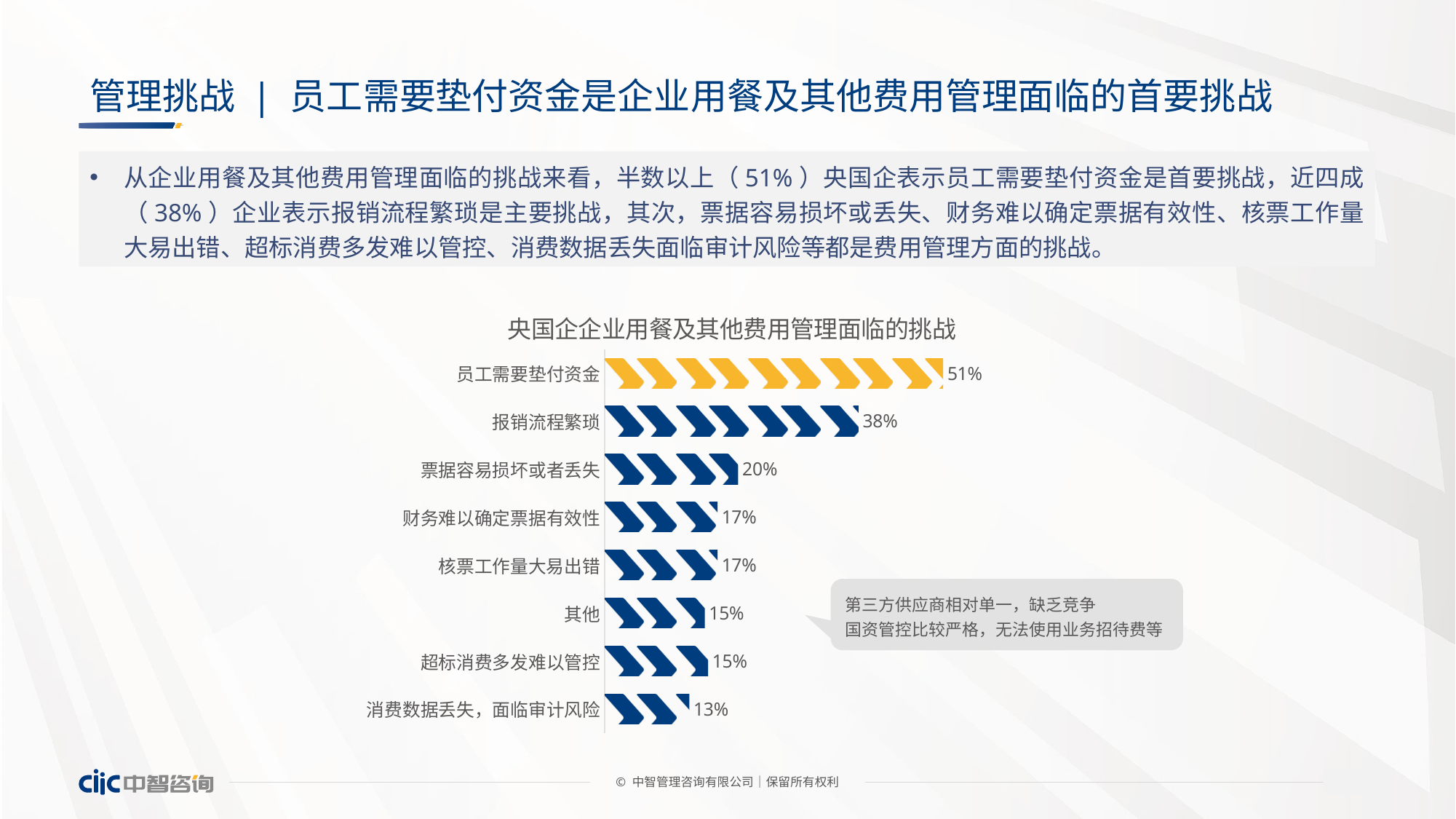
What is the value for 消费数据丢失，面临审计风险? 13% What is the value for 报销流程繁琐? 38% What is the title of the chart? 央国企企业用餐及其他费用管理面临的挑战 Which category has the lowest value? 消费数据丢失，面临审计风险 What kind of chart is shown on the slide? Bar chart How many categories are shown in the chart? 8 What is the value for 员工需要垫付资金? 51% What is the difference between the values for 员工需要垫付资金 and 报销流程繁琐? 13% Which is larger, the value for 票据容易损坏或者丢失 or the value for 其他? 票据容易损坏或者丢失 What is the value for 票据容易损坏或者丢失? 20% Which bar is shown in a different colour (yellow) from the others? 员工需要垫付资金 Which category has the highest value? 员工需要垫付资金